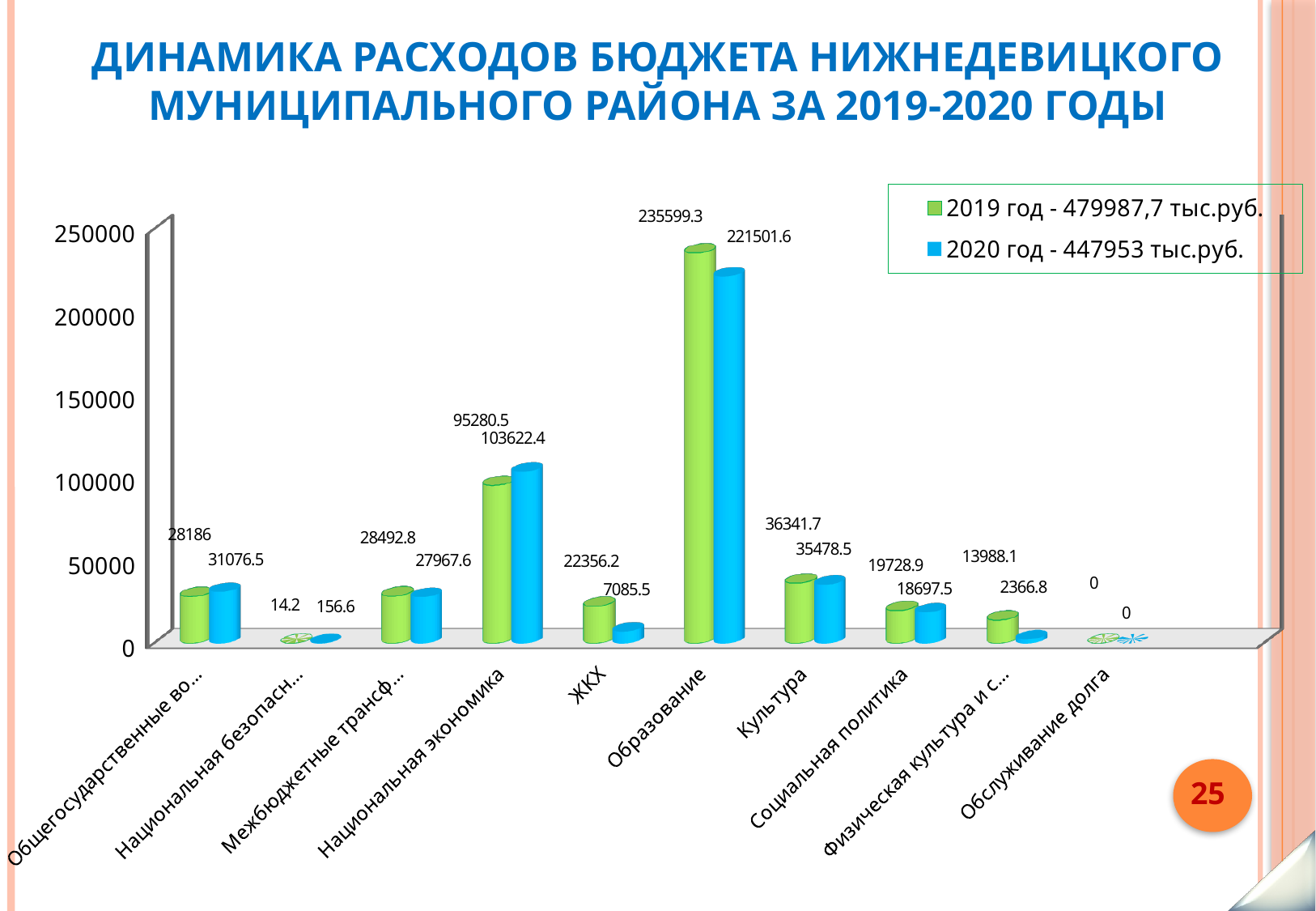
How many series does the legend list? 2 How many categories are shown on the x axis? 10 What is the difference between the 2019 and 2020 values for ЖКХ? 15270.7 What is the 2020 value for ЖКХ? 7085.5 What kind of chart is shown on the slide? bar chart For Национальная экономика, which year has the larger value, 2019 or 2020? 2020 Which category has the highest 2019 value? Образование Is the 2020 value for Образование greater or less than 200000? greater What is the 2019 value for Образование? 235599.3 What is the 2019 value for Культура? 36341.7 What is the 2020 value for Национальная экономика? 103622.4 What is the difference between the 2019 and 2020 values for Образование? 14097.7